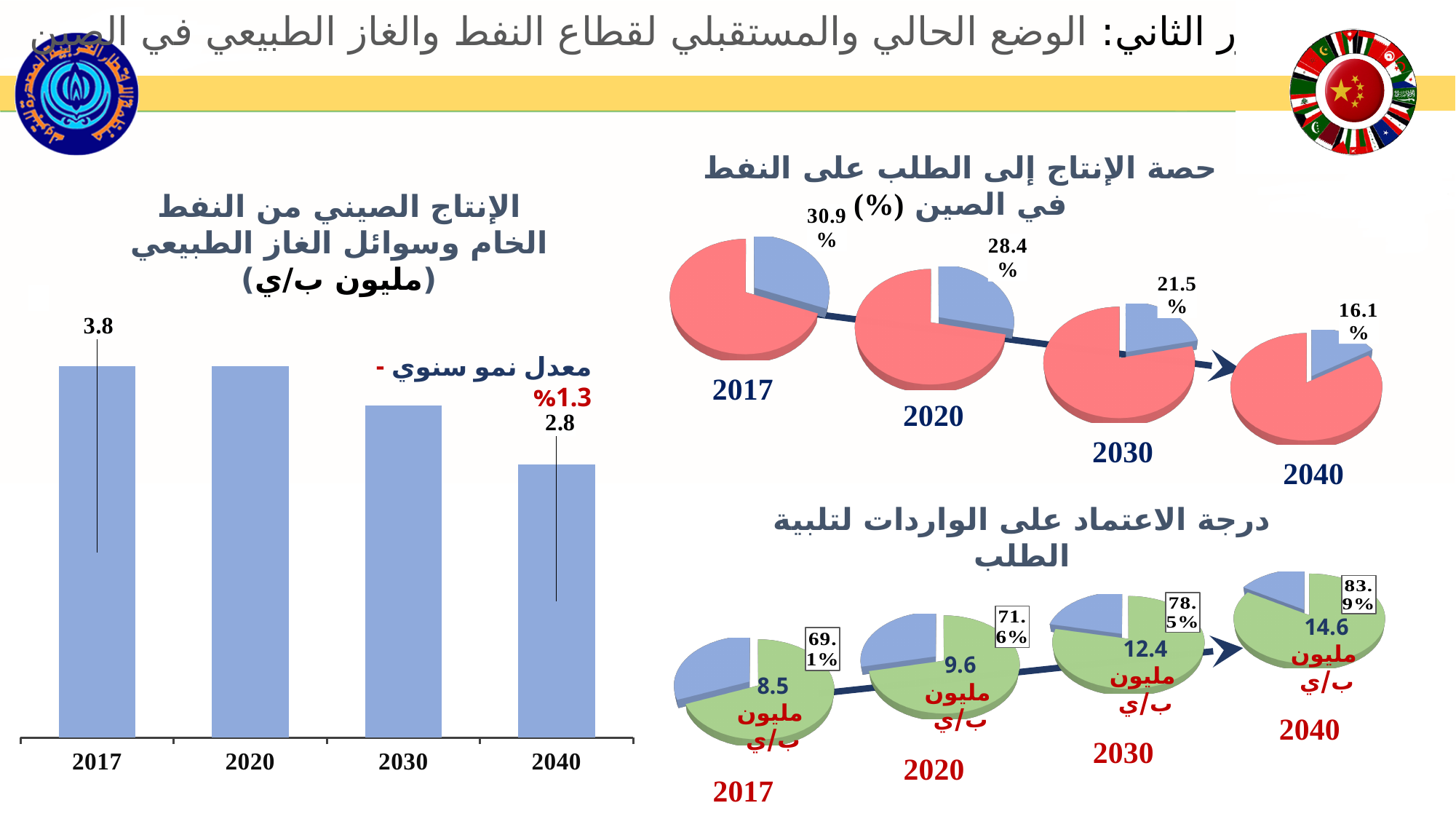
In the series of pie charts at the bottom right of the slide, which year has the highest percentage? 2040 In the bar chart on the left of the slide, what is the value for 2017? 3.8 In the series of pie charts at the bottom right of the slide, what percentage is shown for 2030? 78.5% What kind of chart is shown on the left of the slide? bar chart In the series of pie charts at the top right of the slide, what percentage is shown for 2017? 30.9% In the series of pie charts at the top right of the slide, what percentage is shown for 2040? 16.1% In the bar chart on the left of the slide, what is the difference between the 2017 value and the 2040 value? 1.0 In the bar chart on the left of the slide, how many years are shown on the x axis? 4 In the series of pie charts at the bottom right of the slide, what is the difference between the 2040 percentage and the 2017 percentage? 14.8% In the bar chart on the left of the slide, which year has the lowest bar? 2040 In the bar chart on the left of the slide, what is the value for 2040? 2.8 In the bar chart on the left of the slide, do the values rise or fall from 2017 to 2040? fall